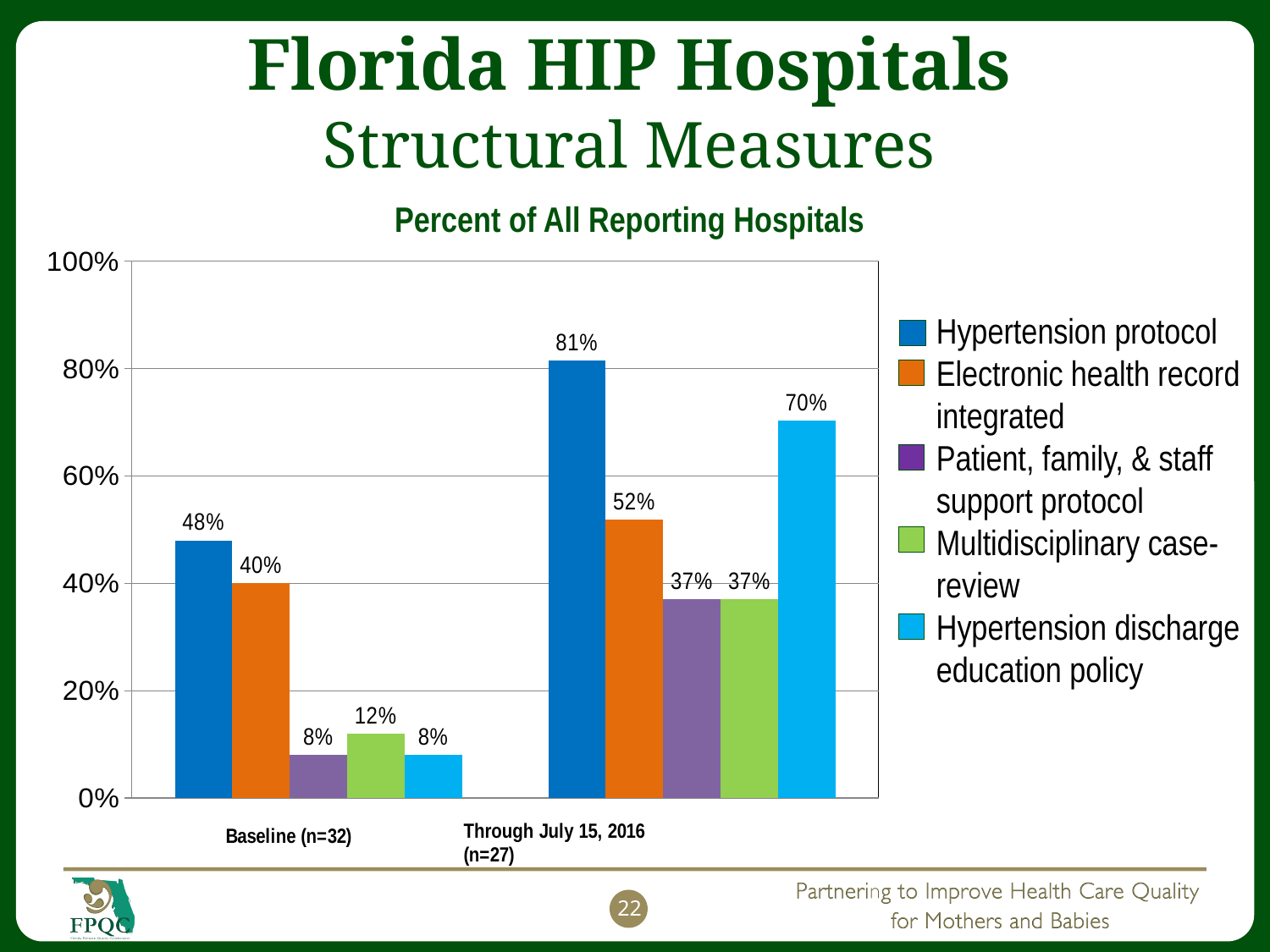
Which is larger: Electronic health record integrated at Baseline or Hypertension discharge education policy Through July 15, 2016? Hypertension discharge education policy Through July 15, 2016 Is the value for Electronic health record integrated Through July 15, 2016 greater or less than 60%? less Which series has the highest value Through July 15, 2016 (n=27)? Hypertension protocol What is the chart's title? Percent of All Reporting Hospitals What is the value for Multidisciplinary case-review at Baseline (n=32)? 12% Which series has the lowest value at Baseline (n=32)? Patient, family, & staff support protocol and Hypertension discharge education policy (both 8%) What is the value for Hypertension discharge education policy Through July 15, 2016 (n=27)? 70% What is the value for Hypertension protocol at Baseline (n=32)? 48% How many series does the legend list? 5 What kind of chart is shown on the slide? bar chart What is the difference between the Hypertension protocol value Through July 15, 2016 and at Baseline? 33 percentage points How many categories are shown on the x axis? 2